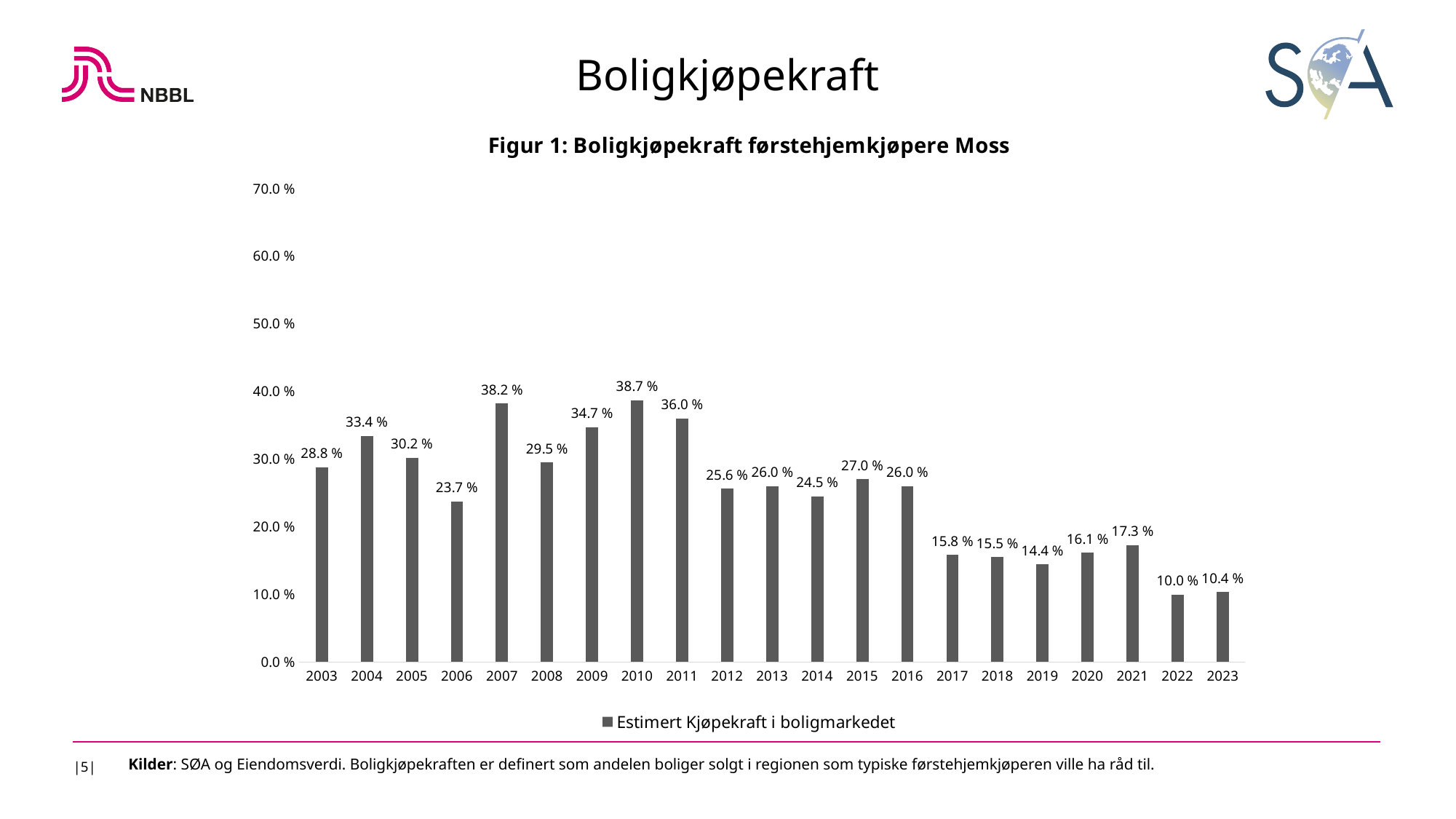
How many series does the legend list? 1 How many years are shown on the x axis? 21 Is the value for 2015 greater or less than 30.0 %? less What is the value for 2006? 23.7 % What is the value for 2023? 10.4 % Which year has the highest value? 2010 What is the value for 2010? 38.7 % Which year has the lowest value? 2022 What is the title of the chart? Figur 1: Boligkjøpekraft førstehjemkjøpere Moss Which is larger, the value for 2004 or the value for 2009? 2009 What is the difference between the values for 2007 and 2008? 8.7 % What kind of chart is shown? bar chart